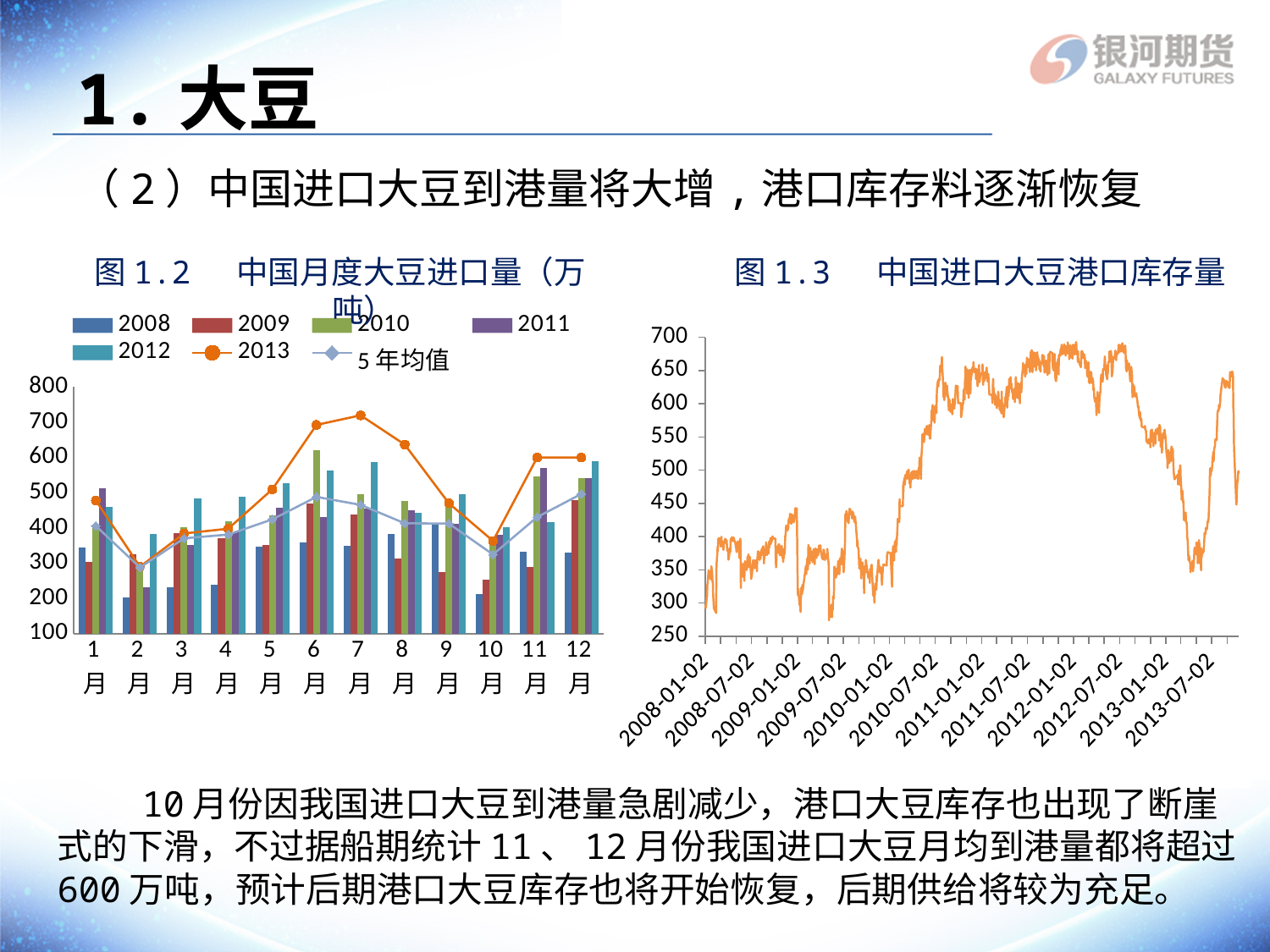
In 图1.2 中国月度大豆进口量, in which month does the 2013 line reach its highest value? 7月 Which series in 图1.2 中国月度大豆进口量 is drawn as an orange line with circle markers? 2013 What kind of chart is 图1.3 中国进口大豆港口库存量 on the right? line chart In 图1.2 中国月度大豆进口量, in which month does the 2013 line reach its lowest value? 2月 In 图1.2 中国月度大豆进口量, is the 2013 value for 6月 larger than the 2013 value for 10月? yes How many series does the legend of 图1.2 中国月度大豆进口量 list? 7 In 图1.3 中国进口大豆港口库存量, is the value at the start of 2008 greater or less than 350? less In 图1.3 中国进口大豆港口库存量, does the line rise or fall between 2010-07-02 and 2011-01-02? rise In 图1.2 中国月度大豆进口量, does the 2013 line rise or fall from 7月 to 10月? fall In 图1.2 中国月度大豆进口量, is the 2013 value for 2月 greater or less than 400? less In 图1.2 中国月度大豆进口量, is the 2013 value for 7月 greater or less than 600? greater How many month categories are shown on the x axis of 图1.2 中国月度大豆进口量? 12